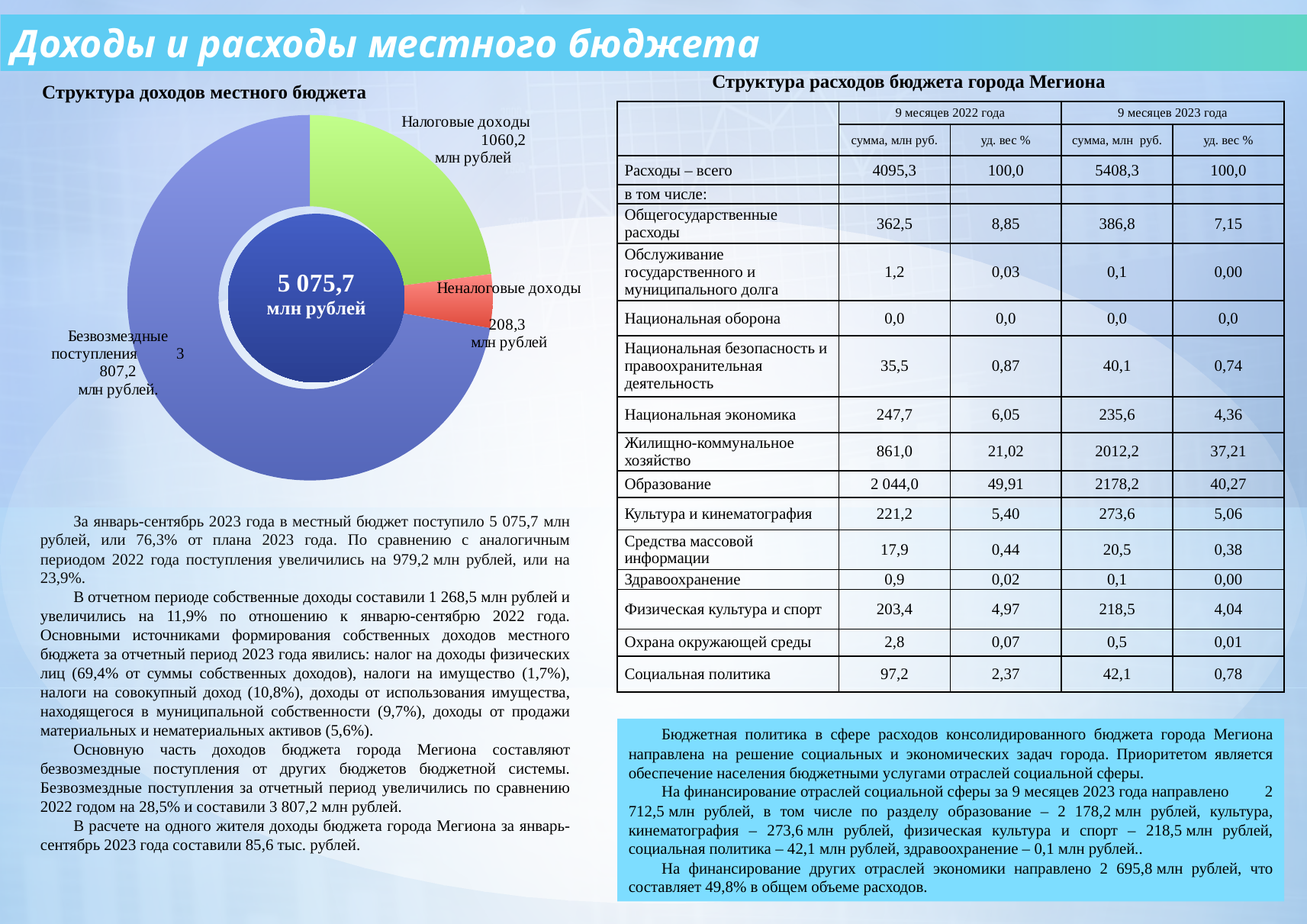
What is the value for Неналоговые доходы in the chart? 208,3 млн рублей Which is larger in the chart: Налоговые доходы or Неналоговые доходы? Налоговые доходы How many categories are shown in the chart Структура доходов местного бюджета? 3 What is the value for Безвозмездные поступления in the chart? 3 807,2 млн рублей What is the difference between Налоговые доходы and Неналоговые доходы in the chart, in млн рублей? 851,9 What colour is the Налоговые доходы slice in the chart? Green What total is shown in the centre of the doughnut chart? 5 075,7 млн рублей Which category has the smallest slice in the chart? Неналоговые доходы What is the value for Налоговые доходы in the chart Структура доходов местного бюджета? 1060,2 млн рублей Which category has the largest slice in the chart? Безвозмездные поступления What kind of chart is used to show the structure of local budget revenues? Pie (doughnut) chart What share of the total 5 075,7 млн рублей do Безвозмездные поступления make up in the chart? 75%